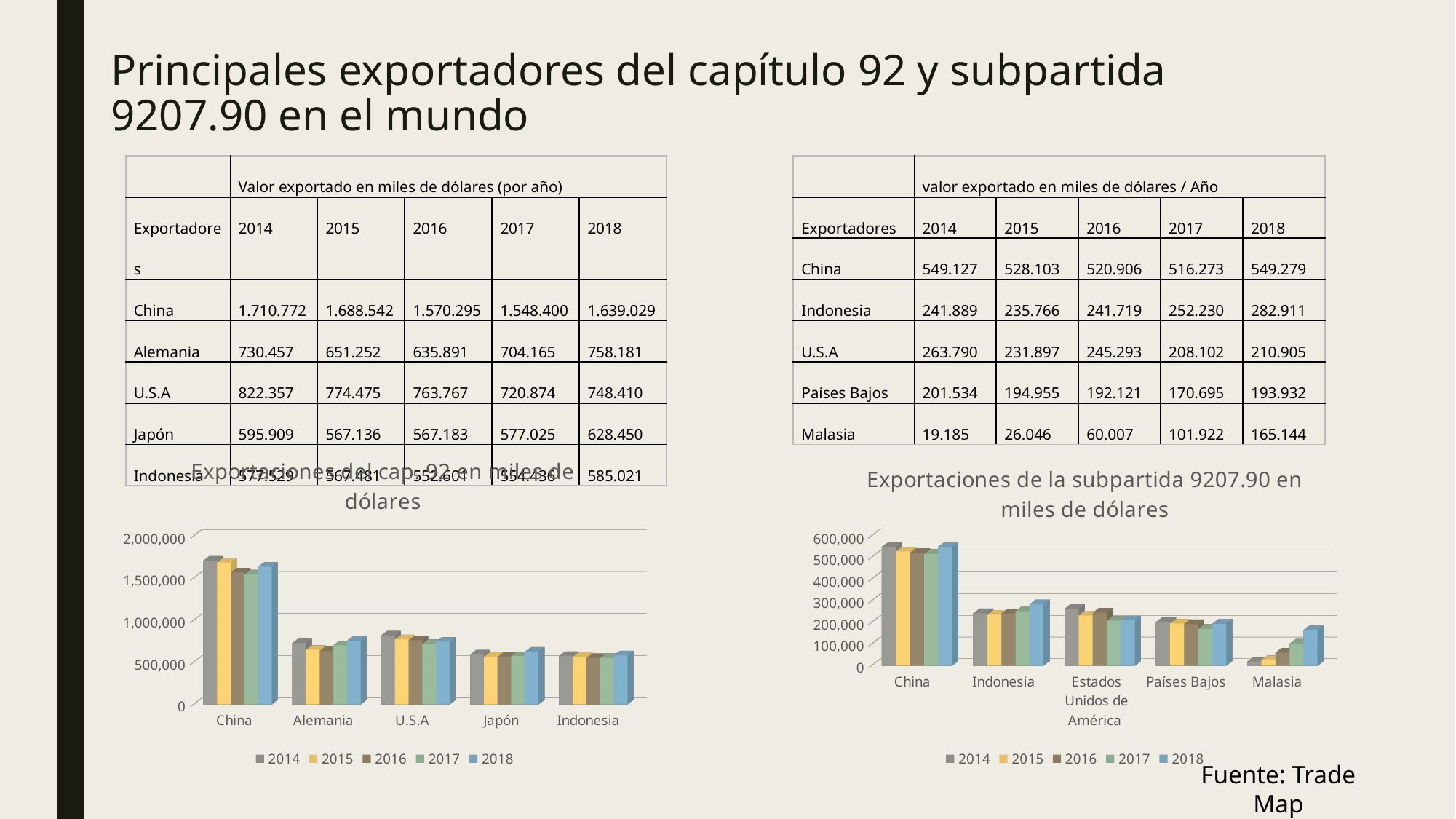
In the left chart, 'Exportaciones del cap. 92 en miles de dólares', is the 2014 value for China greater or less than 1,500,000? greater In the right chart, 'Exportaciones de la subpartida 9207.90 en miles de dólares', which exporter has the lowest value for 2014? Malasia According to the right table, what is the difference between Malasia's exported value in 2018 and in 2014 for subpartida 9207.90? 145.959 In the right chart, 'Exportaciones de la subpartida 9207.90 en miles de dólares', which is larger for 2018: Indonesia or Países Bajos? Indonesia In the right chart, 'Exportaciones de la subpartida 9207.90 en miles de dólares', is the 2018 value for Malasia greater or less than 100,000? greater How many series does the legend of the left chart, 'Exportaciones del cap. 92 en miles de dólares', list? 5 According to the left table, what was China's exported value in 2018 for chapter 92? 1.639.029 In the right chart, 'Exportaciones de la subpartida 9207.90 en miles de dólares', how many exporter categories are shown on the x axis? 5 What is the title of the right chart? Exportaciones de la subpartida 9207.90 en miles de dólares What kind of chart is the left chart, 'Exportaciones del cap. 92 en miles de dólares'? Bar chart In the right chart, 'Exportaciones de la subpartida 9207.90 en miles de dólares', do the values for Malasia rise or fall from 2014 to 2018? rise In the left chart, 'Exportaciones del cap. 92 en miles de dólares', which exporter has the highest value for 2014? China